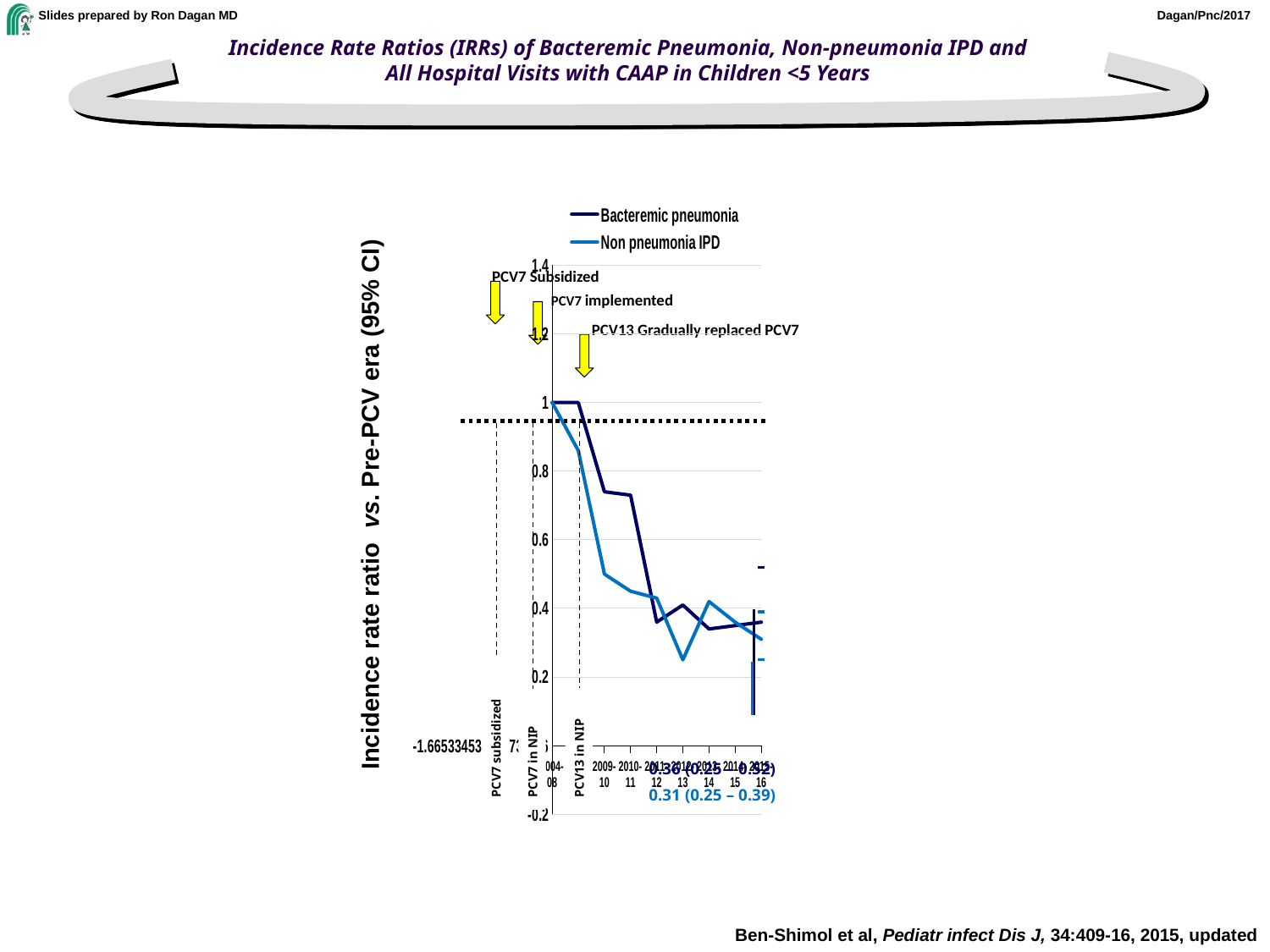
Is the value for Bacteremic pneumonia in 2009-10 greater or less than 0.6? greater What are the two series named in the chart legend? Bacteremic pneumonia and Non pneumonia IPD Overall, do the incidence rate ratios rise or fall from 2004-08 to 2015-16? fall In 2009-10, which series has the higher incidence rate ratio, Bacteremic pneumonia or Non pneumonia IPD? Bacteremic pneumonia What is the title of the chart's y axis? Incidence rate ratio vs. Pre-PCV era (95% CI) How many series does the chart legend list? 2 Is the value for Non pneumonia IPD in 2009-10 greater or less than 0.6? less In 2012-13, which series has the higher incidence rate ratio, Bacteremic pneumonia or Non pneumonia IPD? Bacteremic pneumonia What kind of chart is shown on the slide? line chart Is the value for Bacteremic pneumonia in 2004-08 greater or less than 0.8? greater What is the printed incidence rate ratio (95% CI) for Non pneumonia IPD in 2015-16? 0.31 (0.25 – 0.39) How many time periods are shown along the x axis of the chart? 9